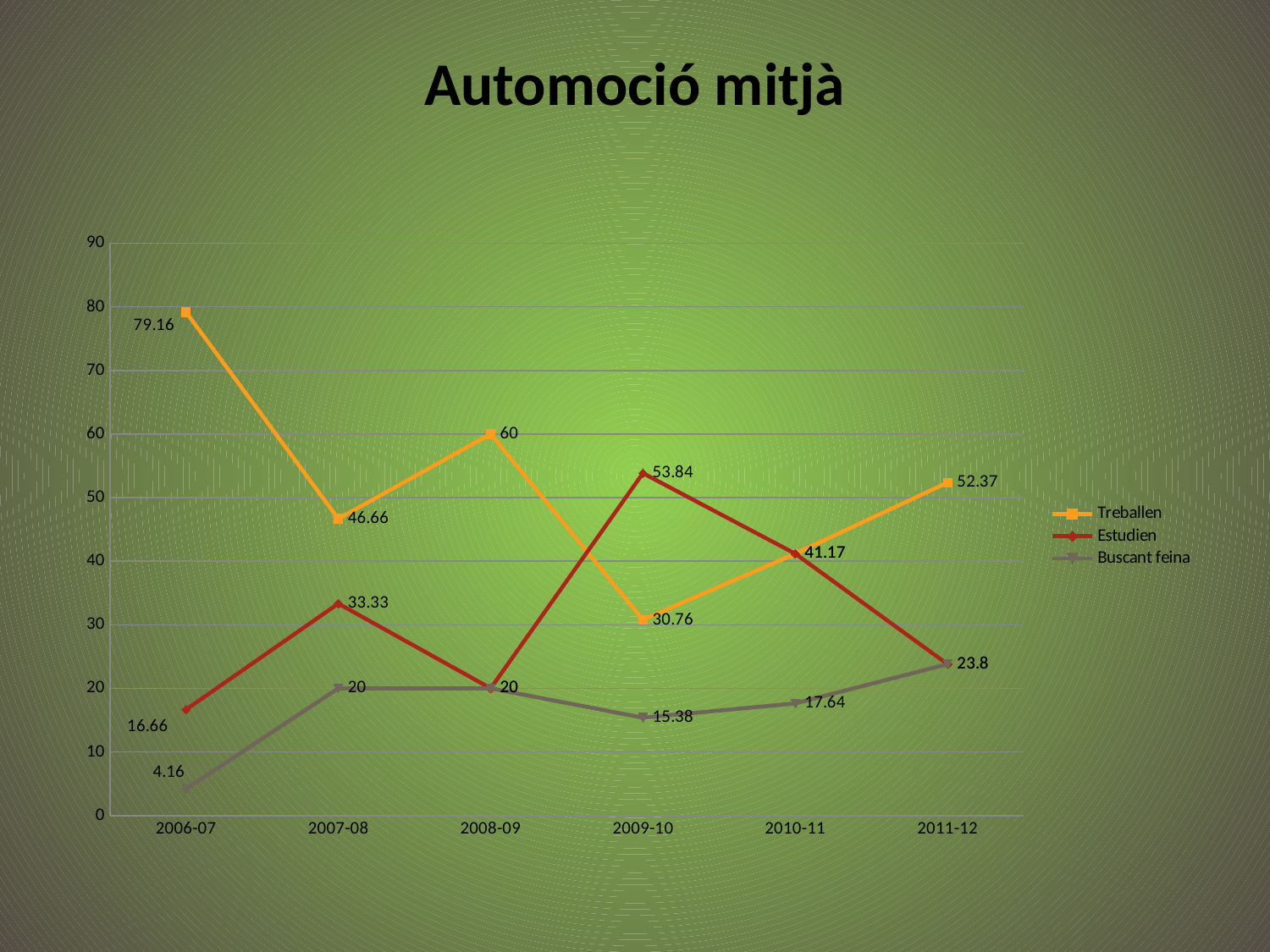
What is the value for Buscant feina in 2006-07? 4.16 Is the value for Estudien in 2010-11 greater or less than 50? less How many academic years are shown on the x axis? 6 What is the difference between the Treballen values for 2006-07 and 2007-08? 32.5 What is the value for Treballen in 2006-07? 79.16 In 2009-10, which is larger: Estudien or Treballen? Estudien In which year is the Treballen value lowest? 2009-10 What is the value for Estudien in 2009-10? 53.84 What type of chart is shown on the slide? line chart What is the value for Buscant feina in 2010-11? 17.64 In which year is the Treballen value highest? 2006-07 How many series does the legend list? 3